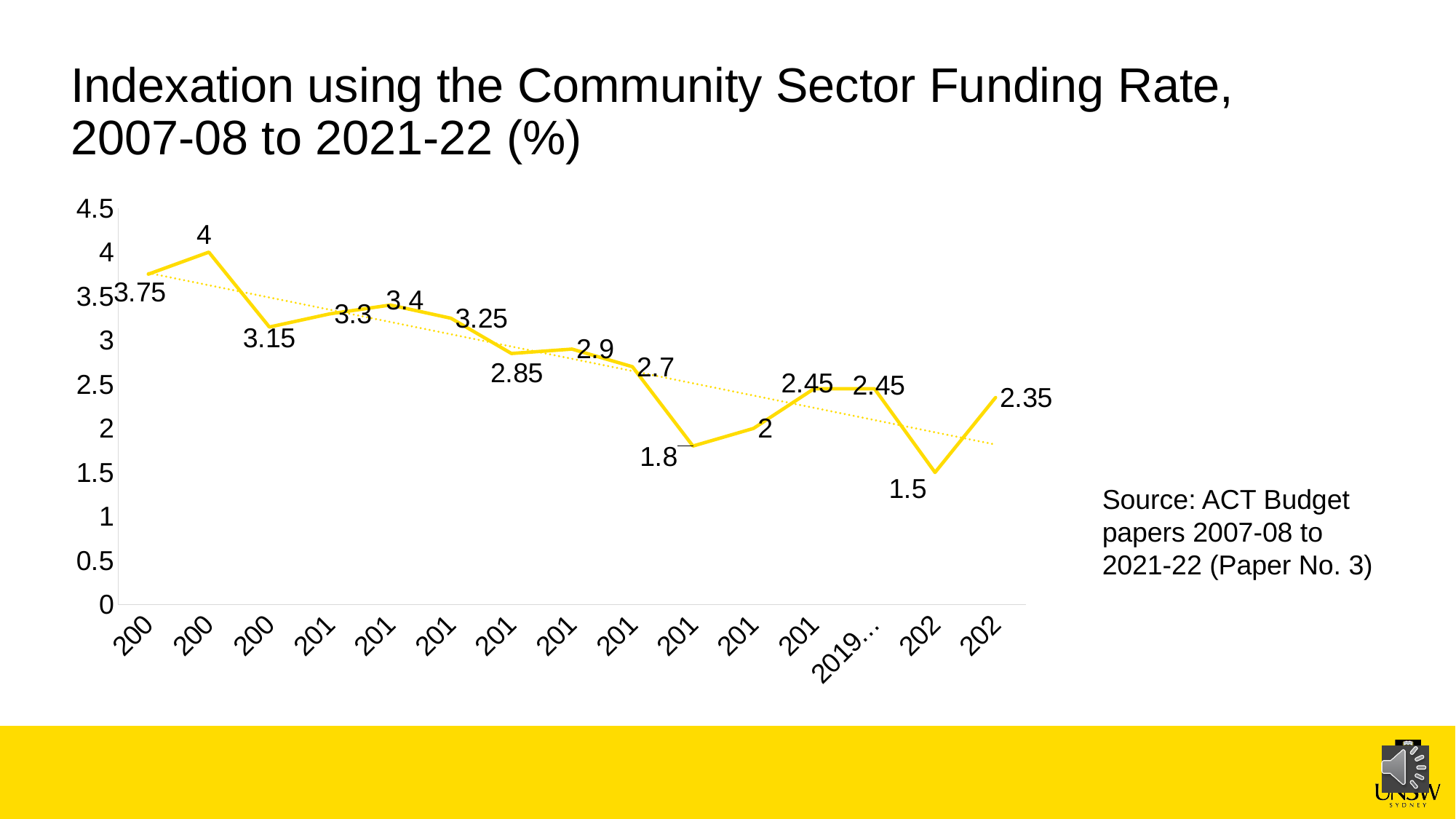
What type of chart is shown on the slide? Line chart What is the difference between the highest value (4) and the lowest value (1.5) on the line? 2.5 How many data points are plotted on the line? 15 What is the value of the last (rightmost) point on the line? 2.35 What is the difference between the first point (3.75) and the last point (2.35) on the line? 1.4 Which is larger, the value of the first point or the value of the last point on the line? The first point (3.75) What is the value of the first (leftmost) point on the line? 3.75 What is the lowest value shown on the line? 1.5 Does the line generally rise or fall from left to right? Fall What is the title of the chart? Indexation using the Community Sector Funding Rate, 2007-08 to 2021-22 (%) How many data points have a value of exactly 2.45? 2 What is the highest value shown on the line? 4